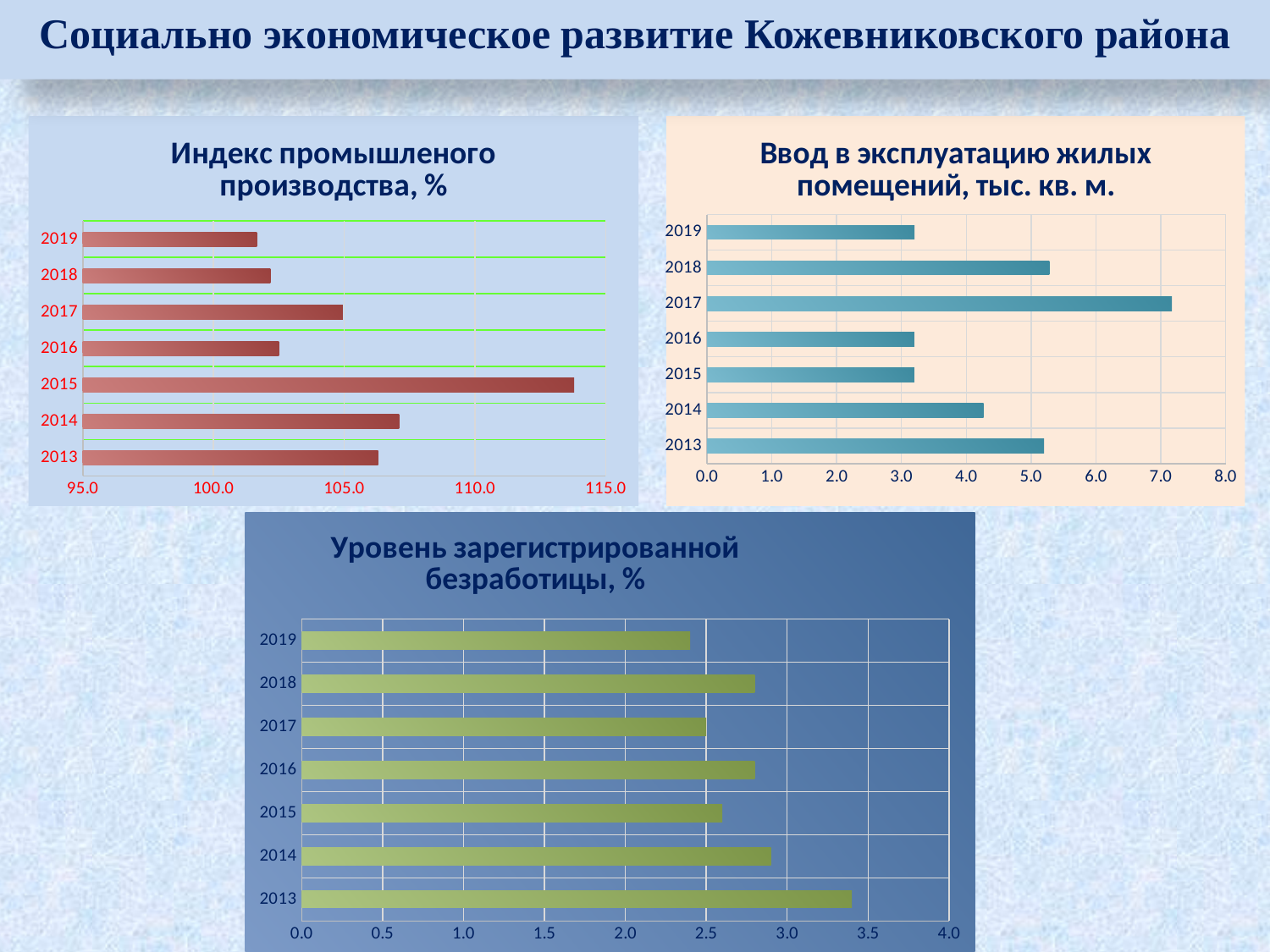
In the chart 'Ввод в эксплуатацию жилых помещений, тыс. кв. м.', is the value for 2017 greater or less than 7.0? greater How many years are shown in the chart 'Уровень зарегистрированной безработицы, %'? 7 In the chart 'Индекс промышленого производства, %', which is larger, the value for 2014 or the value for 2016? 2014 In the chart 'Индекс промышленого производства, %', is the value for 2015 greater or less than 110.0? greater In the chart 'Уровень зарегистрированной безработицы, %', which year has the highest value? 2013 In the chart 'Ввод в эксплуатацию жилых помещений, тыс. кв. м.', which is larger, the value for 2018 or the value for 2019? 2018 In the chart 'Уровень зарегистрированной безработицы, %', is the value for 2013 greater or less than 3.0? greater In the chart 'Ввод в эксплуатацию жилых помещений, тыс. кв. м.', which year has the highest value? 2017 What type of chart is 'Ввод в эксплуатацию жилых помещений, тыс. кв. м.'? bar chart In the chart 'Индекс промышленого производства, %', which year has the highest value? 2015